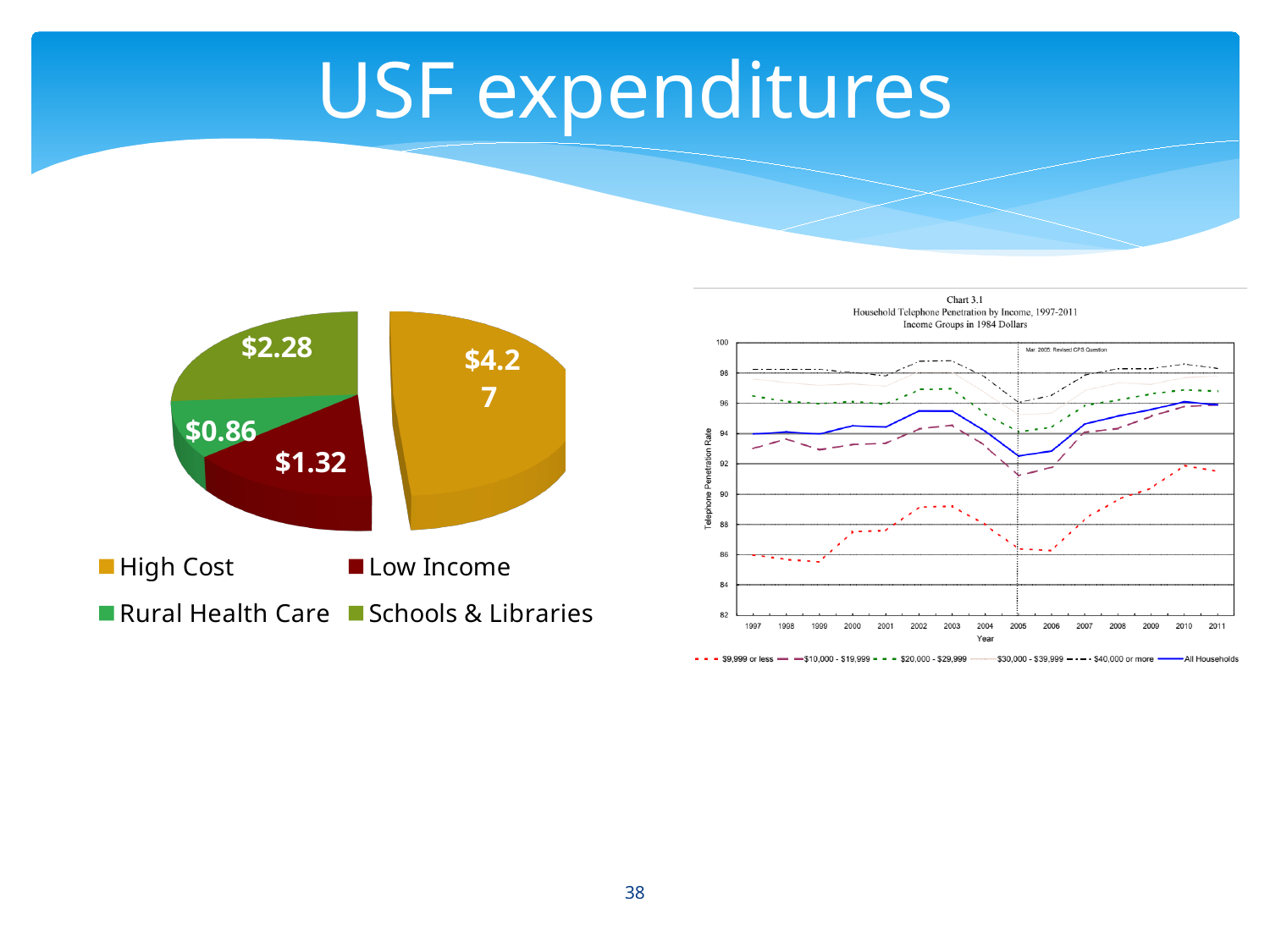
In the pie chart on the left, which category has the smallest value? Rural Health Care How many categories does the pie chart on the left show? 4 What kind of chart is Chart 3.1 (Household Telephone Penetration by Income) on the right of the slide? Line chart In the pie chart on the left, which is larger, Schools & Libraries or Low Income? Schools & Libraries In Chart 3.1 (Household Telephone Penetration by Income), is the value for the $9,999 or less group in 2005 greater or less than 88? less In the pie chart on the left, what is the value for Schools & Libraries? $2.28 In the pie chart on the left, which category has the largest value? High Cost How many series does the legend of Chart 3.1 (Household Telephone Penetration by Income) list? 6 In the pie chart on the left, what is the value for Rural Health Care? $0.86 In the pie chart on the left, what is the difference between the Low Income and Rural Health Care values? $0.46 In the pie chart on the left, what is the value for Low Income? $1.32 What kind of chart is the chart on the left of the slide? Pie chart